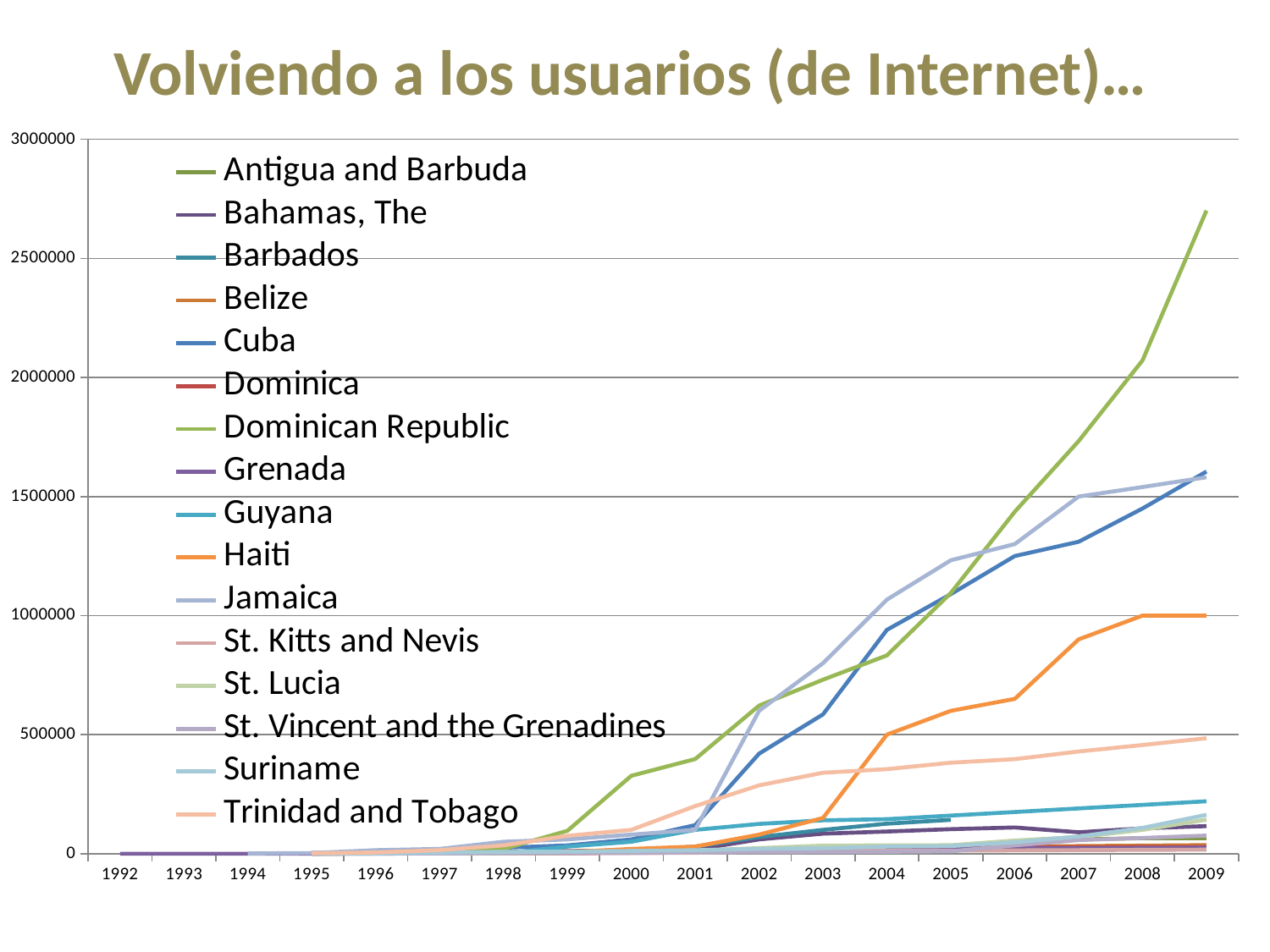
Does the Dominican Republic line rise or fall from 2000 to 2009? rise Is the value for Haiti in 2006 greater or less than 500000? greater Is the value for Cuba in 2009 greater or less than 1500000? greater How many series does the legend list? 16 What kind of chart is shown on the slide? line chart Is the value for Dominican Republic in 2004 greater or less than 1000000? less In 2009, which is larger: the value for Dominican Republic or the value for Cuba? Dominican Republic How many years are shown along the x axis? 18 Which series has the highest value in 2009? Dominican Republic What is the title of the slide? Volviendo a los usuarios (de Internet)… In 2009, which is larger: the value for Haiti or the value for Trinidad and Tobago? Haiti